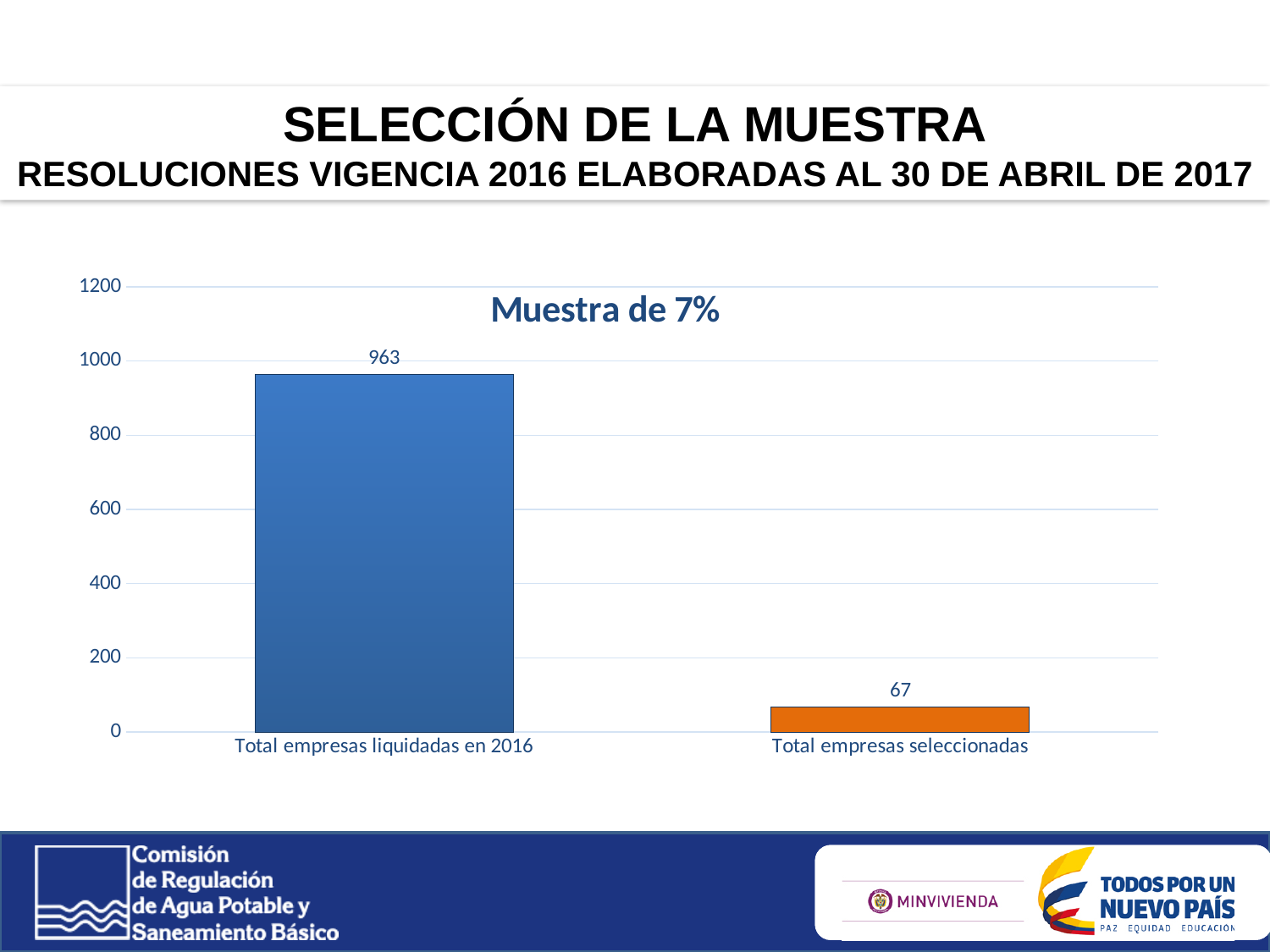
What kind of chart is shown on the slide? bar chart What is the value for Total empresas seleccionadas? 67 Is the value for Total empresas seleccionadas greater or less than 200? less What is the highest value shown on the vertical axis? 1200 Which category has the highest value? Total empresas liquidadas en 2016 How many categories are shown in the chart? 2 What is the difference between Total empresas liquidadas en 2016 and Total empresas seleccionadas? 896 What is the title of the chart? Muestra de 7% Which category has the lowest value? Total empresas seleccionadas Which is larger, Total empresas liquidadas en 2016 or Total empresas seleccionadas? Total empresas liquidadas en 2016 What is the value for Total empresas liquidadas en 2016? 963 Is the value for Total empresas liquidadas en 2016 greater or less than 800? greater